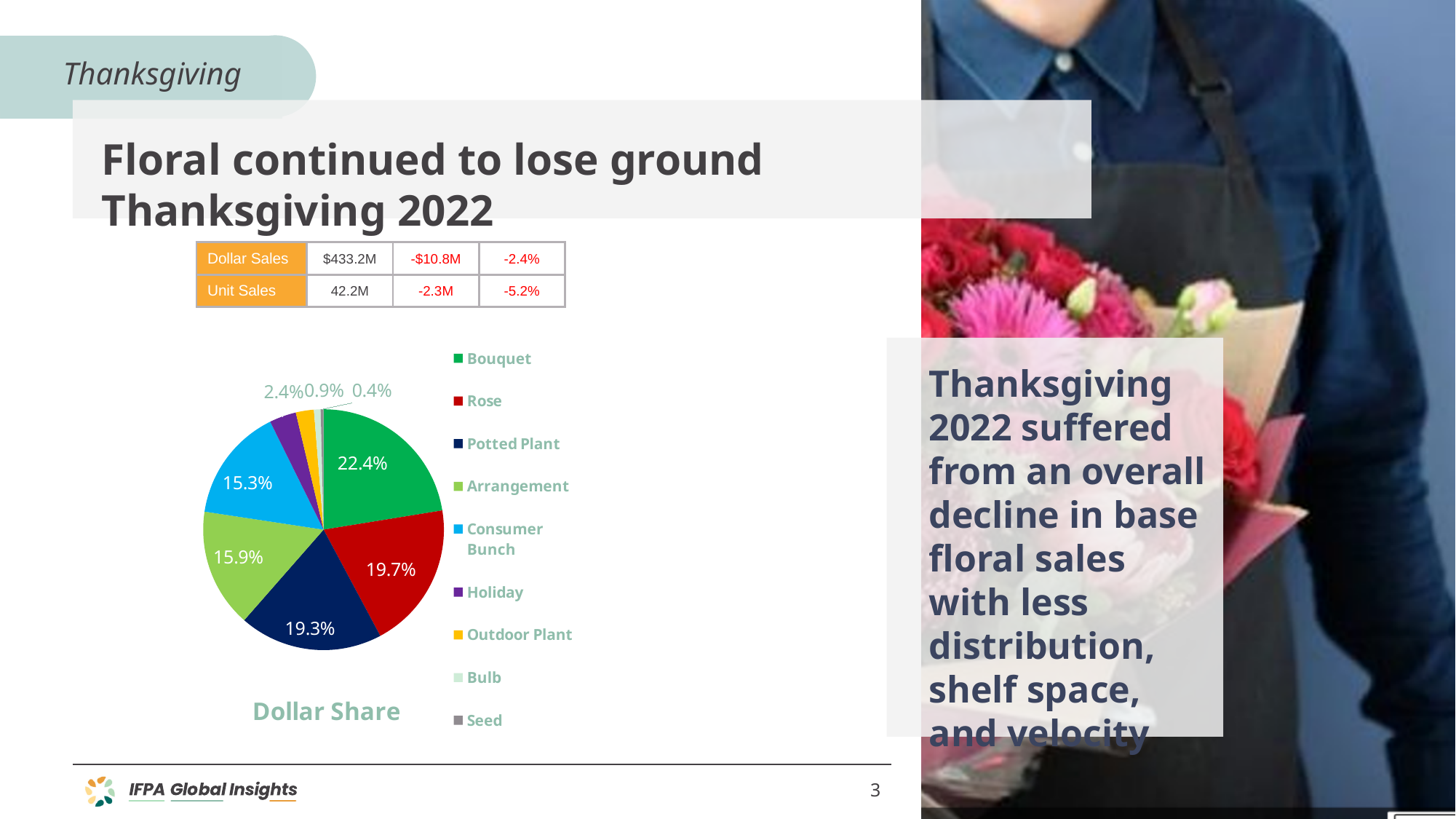
Which has a larger dollar share, Arrangement or Consumer Bunch? Arrangement What is the dollar share for Rose? 19.7% What is the title of the pie chart? Dollar Share What is the dollar share for Bouquet? 22.4% How many categories does the pie chart's legend list? 9 What is the dollar share for Potted Plant? 19.3% What is the difference in dollar share between Bouquet and Rose? 2.7% What is the dollar share for Consumer Bunch? 15.3% What type of chart is shown on the slide? pie chart What is the dollar share for Arrangement? 15.9% Which category has the largest dollar share? Bouquet